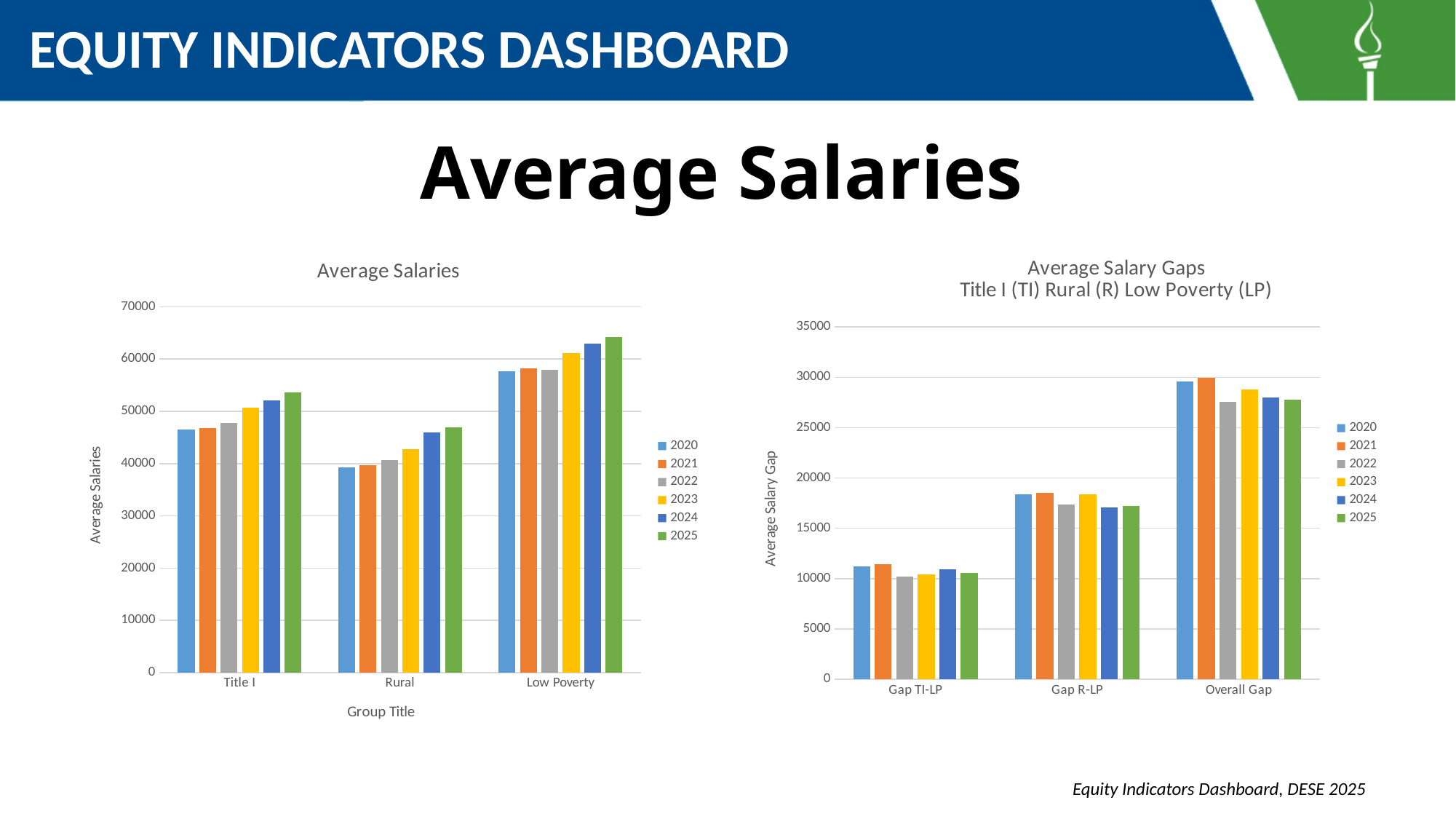
In the 'Average Salaries' chart on the left, which group has the highest 2025 average salary? Low Poverty In the 'Average Salary Gaps' chart on the right, which gap category has the highest values? Overall Gap In the 'Average Salaries' chart on the left, do the Title I values rise or fall from 2020 to 2025? rise In the 'Average Salaries' chart on the left, which group has the lowest 2020 average salary? Rural In the 'Average Salary Gaps' chart on the right, is the 2024 value for Gap R-LP greater or less than 20000? less In the 'Average Salaries' chart on the left, how many series does the legend list? 6 In the 'Average Salaries' chart on the left, is the 2024 value for Low Poverty greater or less than 60000? greater In the 'Average Salaries' chart on the left, is the 2020 value for Title I greater or less than 50000? less In the 'Average Salary Gaps' chart on the right, which is larger for Gap R-LP: the 2021 value or the 2024 value? 2021 What is the y-axis label of the 'Average Salary Gaps' chart on the right? Average Salary Gap What kind of chart is the 'Average Salaries' chart on the left? bar chart In the 'Average Salaries' chart on the left, how many groups are shown on the x axis? 3